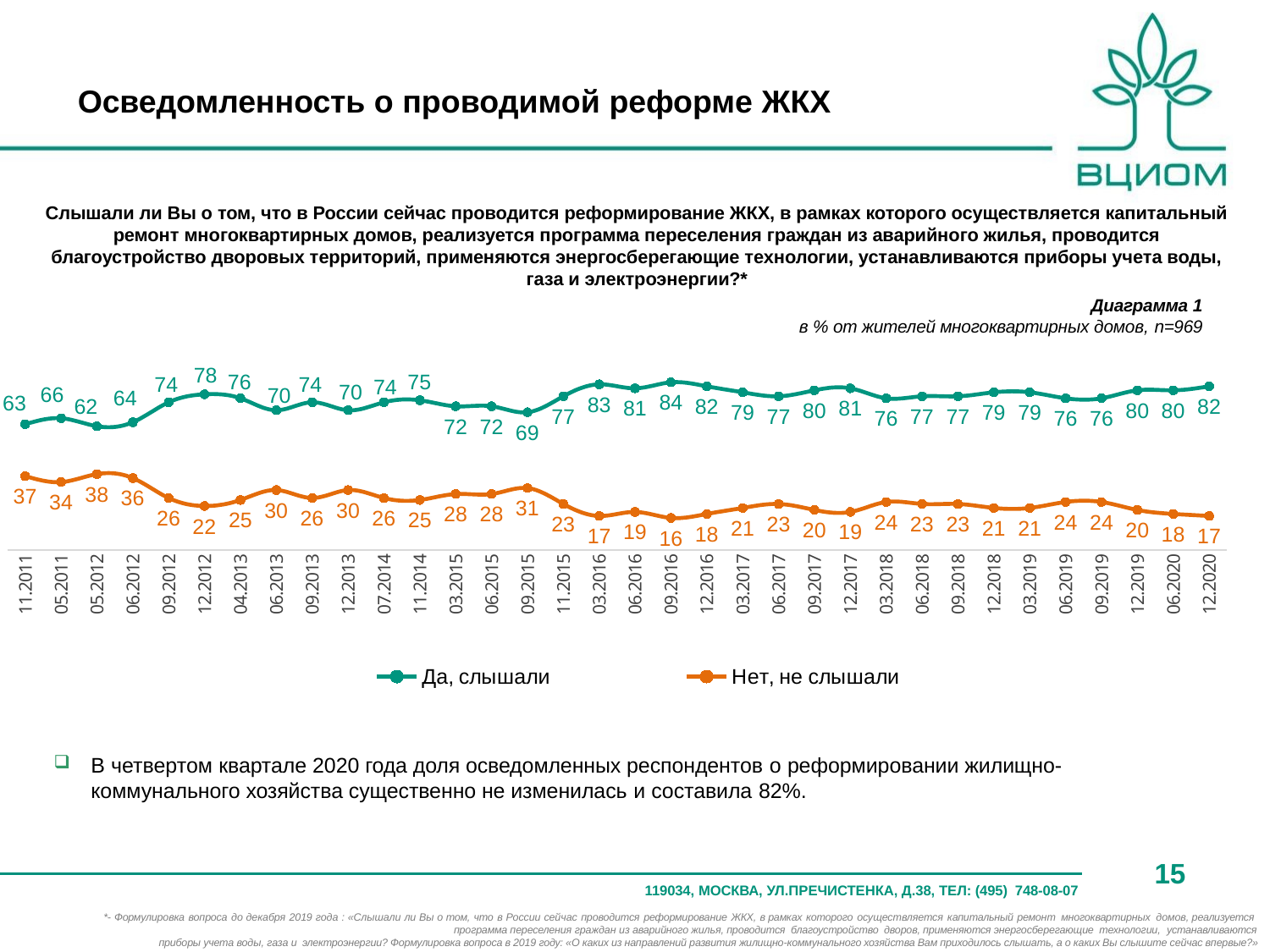
At which date does the "Да, слышали" series reach its highest value? 09.2016 What is the sample size (n) stated above the chart? n=969 At which date does the "Нет, не слышали" series reach its highest value? 05.2012 How many data points does each series have on the chart? 34 What is the difference between the "Да, слышали" and "Нет, не слышали" values at 12.2020? 65 What type of chart is shown on the slide? line chart What is the value for "Да, слышали" at 11.2011? 63 Which series has the larger value at 06.2012: "Да, слышали" or "Нет, не слышали"? Да, слышали At which date does the "Нет, не слышали" series reach its lowest value? 09.2016 What is the value for "Да, слышали" at 12.2020? 82 How many series does the legend list? 2 What is the value for "Нет, не слышали" at 12.2012? 22